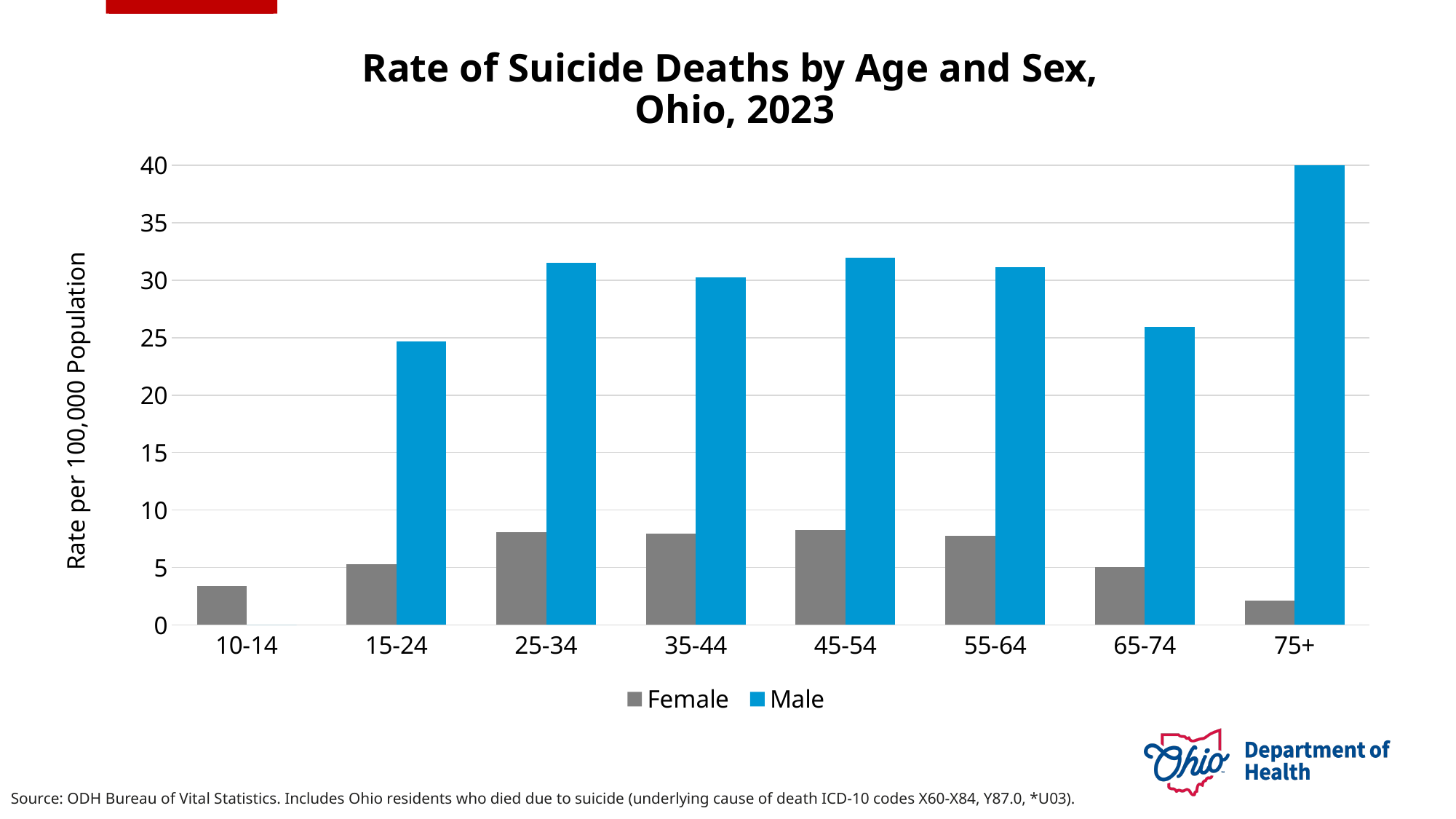
Is the Female value for 55-64 greater or less than 10? less Is the Male value for 25-34 greater or less than 30? greater Is the Female value for 10-14 greater or less than 5? less What is the label of the y axis? Rate per 100,000 Population How many series does the legend list? 2 Which age group has the highest Male suicide death rate? 75+ How many age groups are shown on the x axis? 8 Which is larger, the Male value for 45-54 or the Male value for 65-74? 45-54 Which age group has the lowest Female suicide death rate? 75+ What kind of chart is shown on the slide? bar chart Which age group has the lowest Male suicide death rate? 10-14